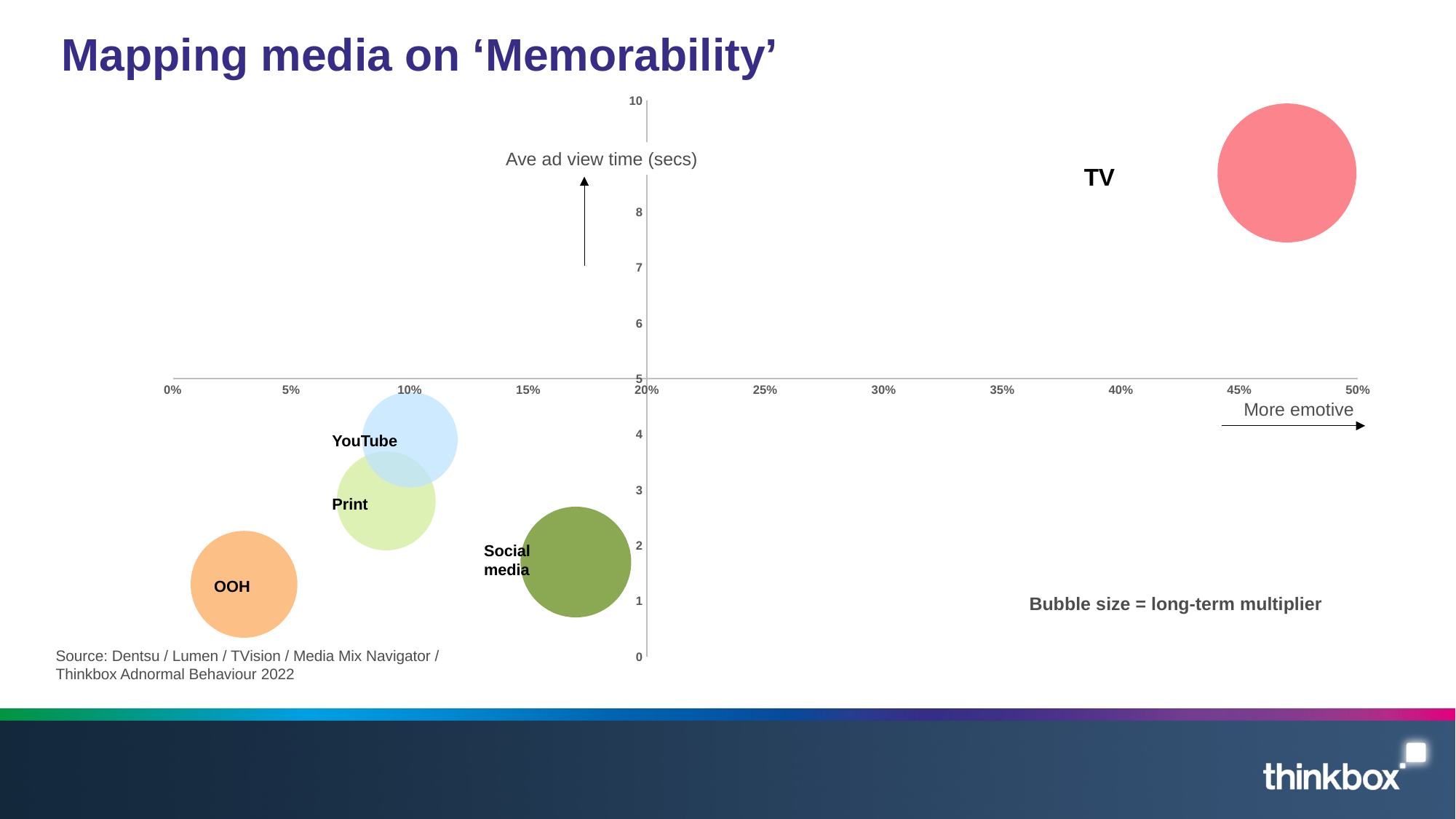
Which medium is furthest to the right on the 'More emotive' axis? TV Is the average ad view time for TV greater or less than 7 seconds? greater Is the 'More emotive' value for TV greater or less than 40%? greater Which medium is furthest to the left on the 'More emotive' axis? OOH Is the 'More emotive' value for OOH greater or less than 5%? less According to the slide, what does the bubble size represent? Long-term multiplier Which has the higher average ad view time, YouTube or Print? YouTube How many media bubbles are plotted on the chart? 5 What kind of chart is shown on the slide? Bubble chart Which is further along the 'More emotive' axis, Social media or OOH? Social media Which medium has the highest average ad view time? TV